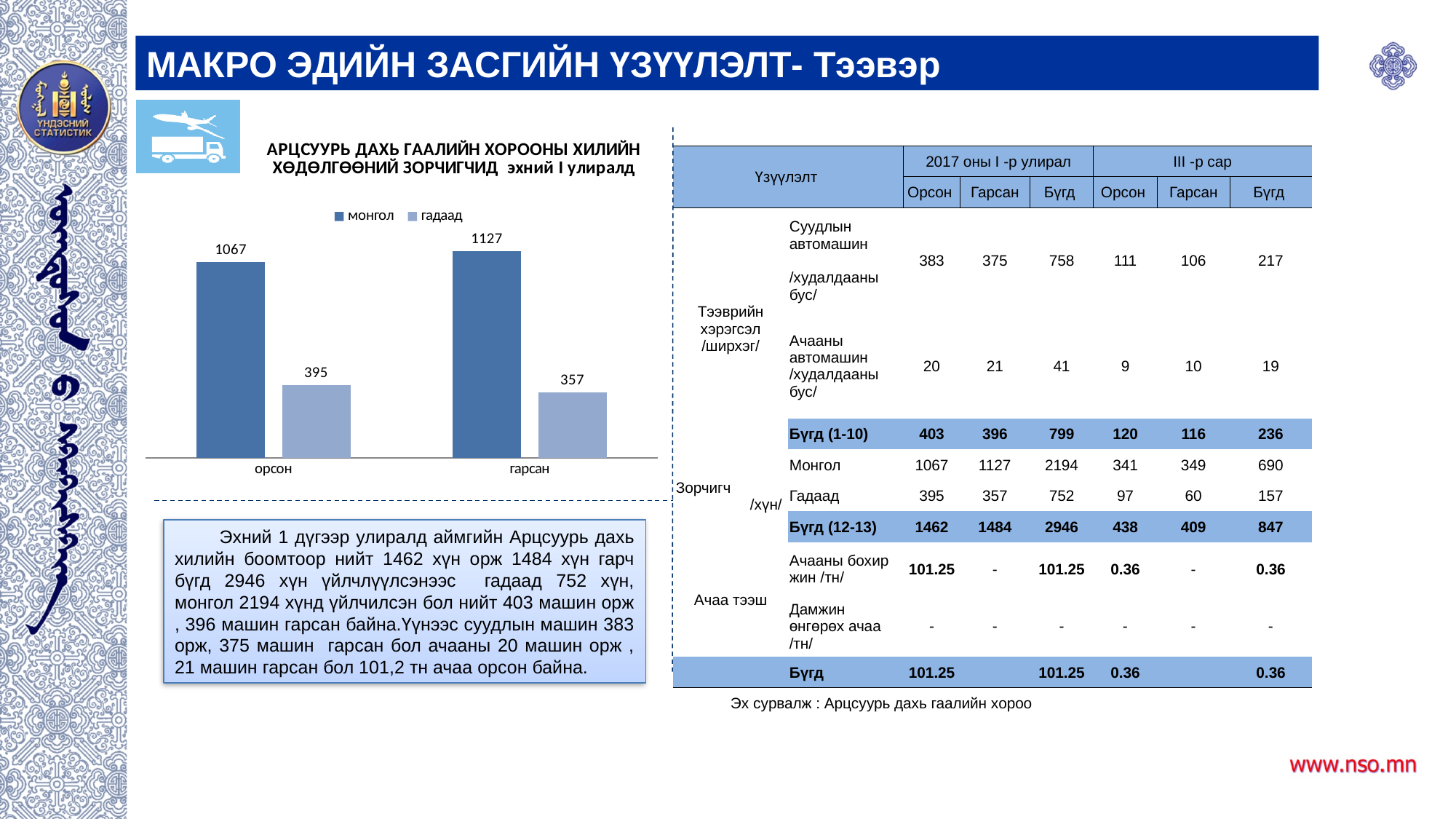
What is the difference between the монгол values for гарсан and орсон? 60 Which bar has the highest value in the chart? монгол, гарсан What is the value for гадаад in the орсон category? 395 What is the value for монгол in the орсон category? 1067 What type of chart is shown on the slide? bar chart What is the value for монгол in the гарсан category? 1127 Which bar has the lowest value in the chart? гадаад, гарсан What is the difference between the монгол and гадаад values in the орсон category? 672 What is the value for гадаад in the гарсан category? 357 How many categories are shown on the x axis of the chart? 2 Which is larger, the гадаад value for орсон or the гадаад value for гарсан? орсон How many series does the chart legend list? 2